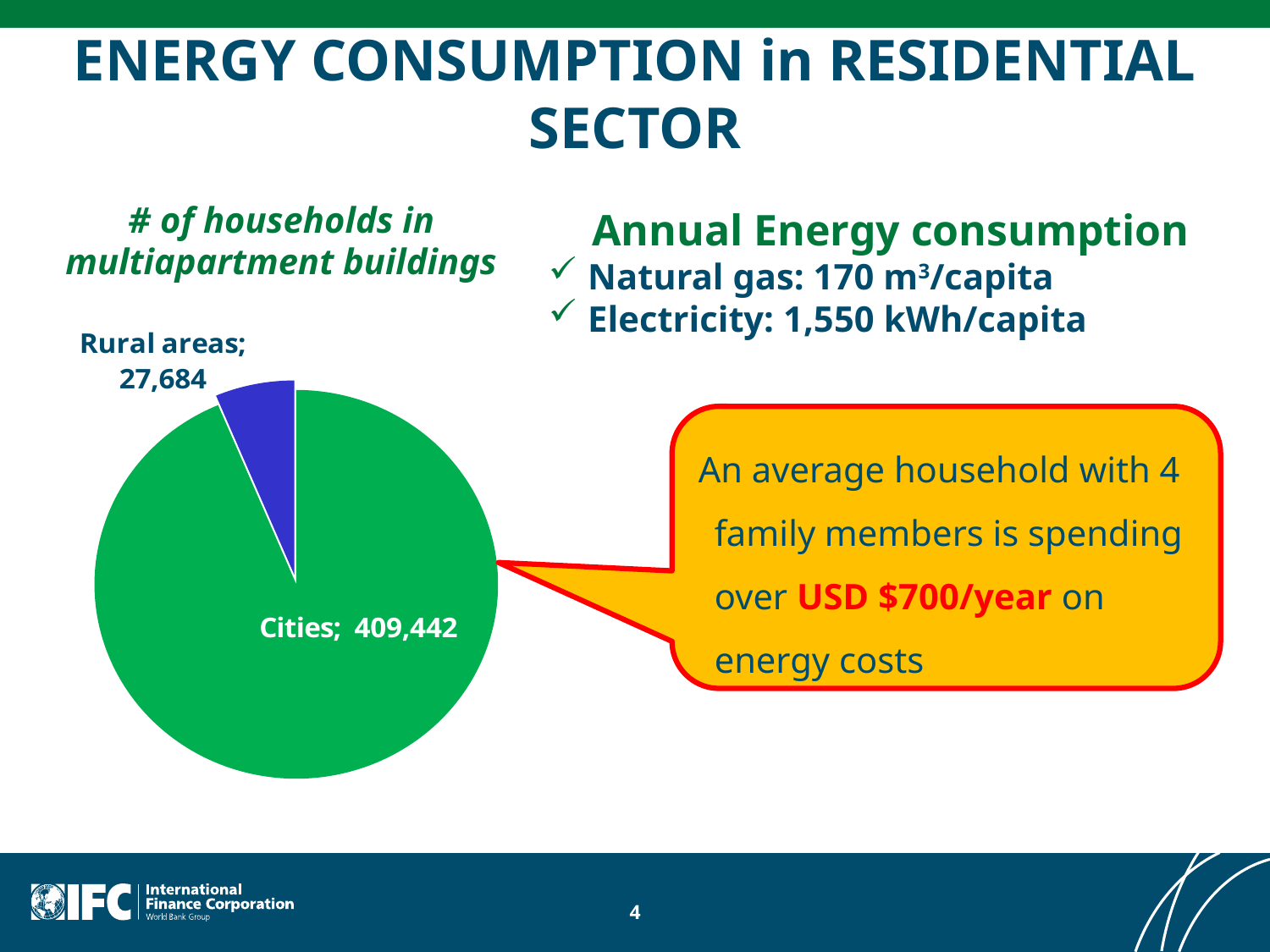
What is the difference between the number of households in cities and in rural areas shown in the pie chart? 381,758 Which category has the smallest slice in the pie chart? Rural areas Which category has the largest slice in the pie chart? Cities How many households in multiapartment buildings are in rural areas according to the pie chart? 27,684 How many households in multiapartment buildings are in cities according to the pie chart? 409,442 What type of chart is used to show the number of households in multiapartment buildings? Pie chart What is the title of the pie chart? # of households in multiapartment buildings What is the total number of households in multiapartment buildings across both slices of the pie chart? 437,126 What colour is the Rural areas slice in the pie chart? Blue How many slices does the pie chart have? 2 Which has more households in multiapartment buildings, cities or rural areas? Cities